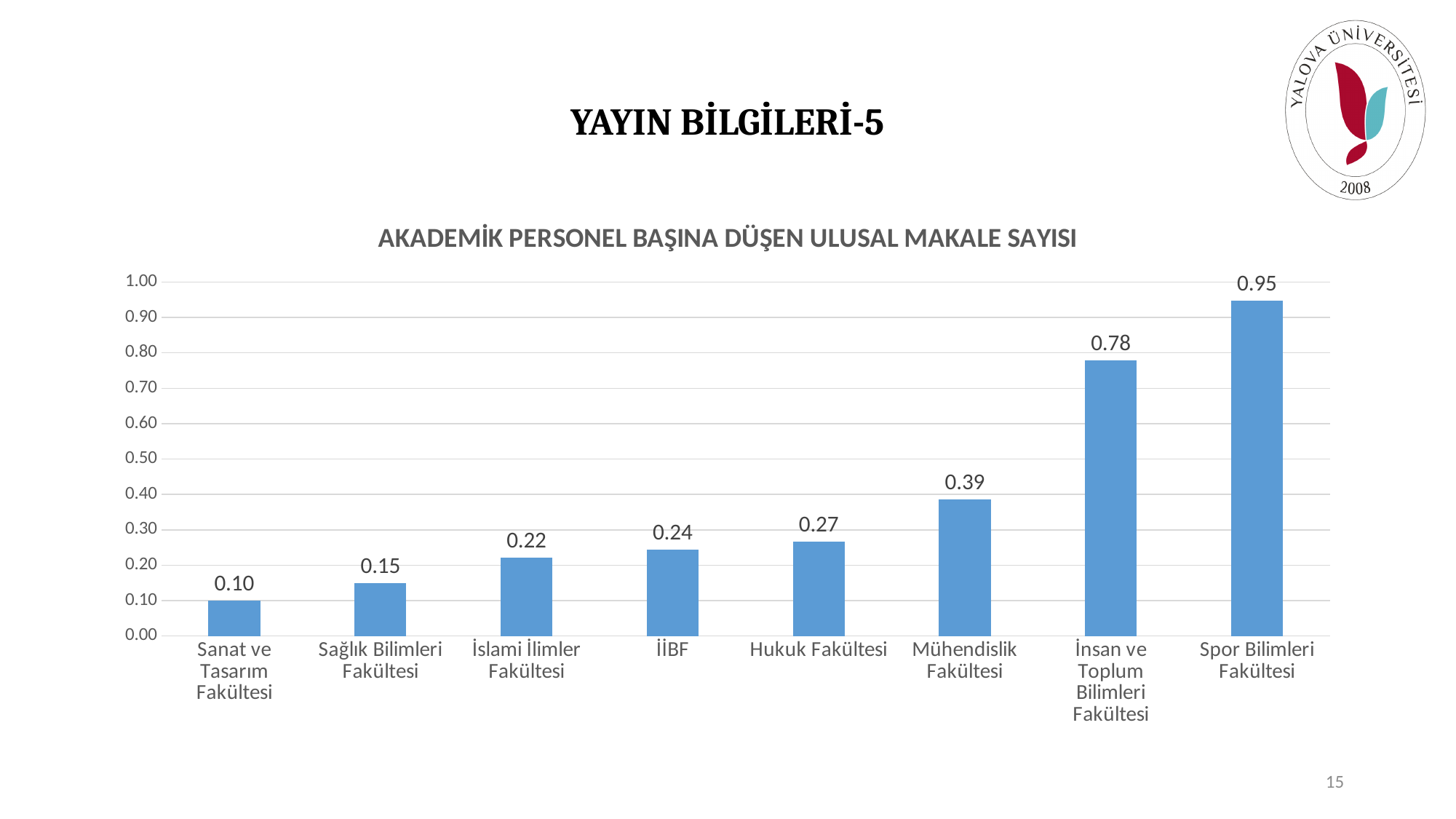
How many faculties are shown on the chart? 8 Which is larger, the value for Mühendislik Fakültesi or the value for İİBF? Mühendislik Fakültesi Is the value for İnsan ve Toplum Bilimleri Fakültesi greater or less than 0.70? greater What kind of chart is shown on the slide? Bar chart Which faculty has the lowest value? Sanat ve Tasarım Fakültesi What is the difference between the values for Spor Bilimleri Fakültesi and İnsan ve Toplum Bilimleri Fakültesi? 0.17 Which faculty has the highest value? Spor Bilimleri Fakültesi What is the value for Hukuk Fakültesi? 0.27 What is the title of the chart? AKADEMİK PERSONEL BAŞINA DÜŞEN ULUSAL MAKALE SAYISI What is the value for Spor Bilimleri Fakültesi? 0.95 What is the value for Sağlık Bilimleri Fakültesi? 0.15 Do the values rise or fall from left to right along the x axis? Rise